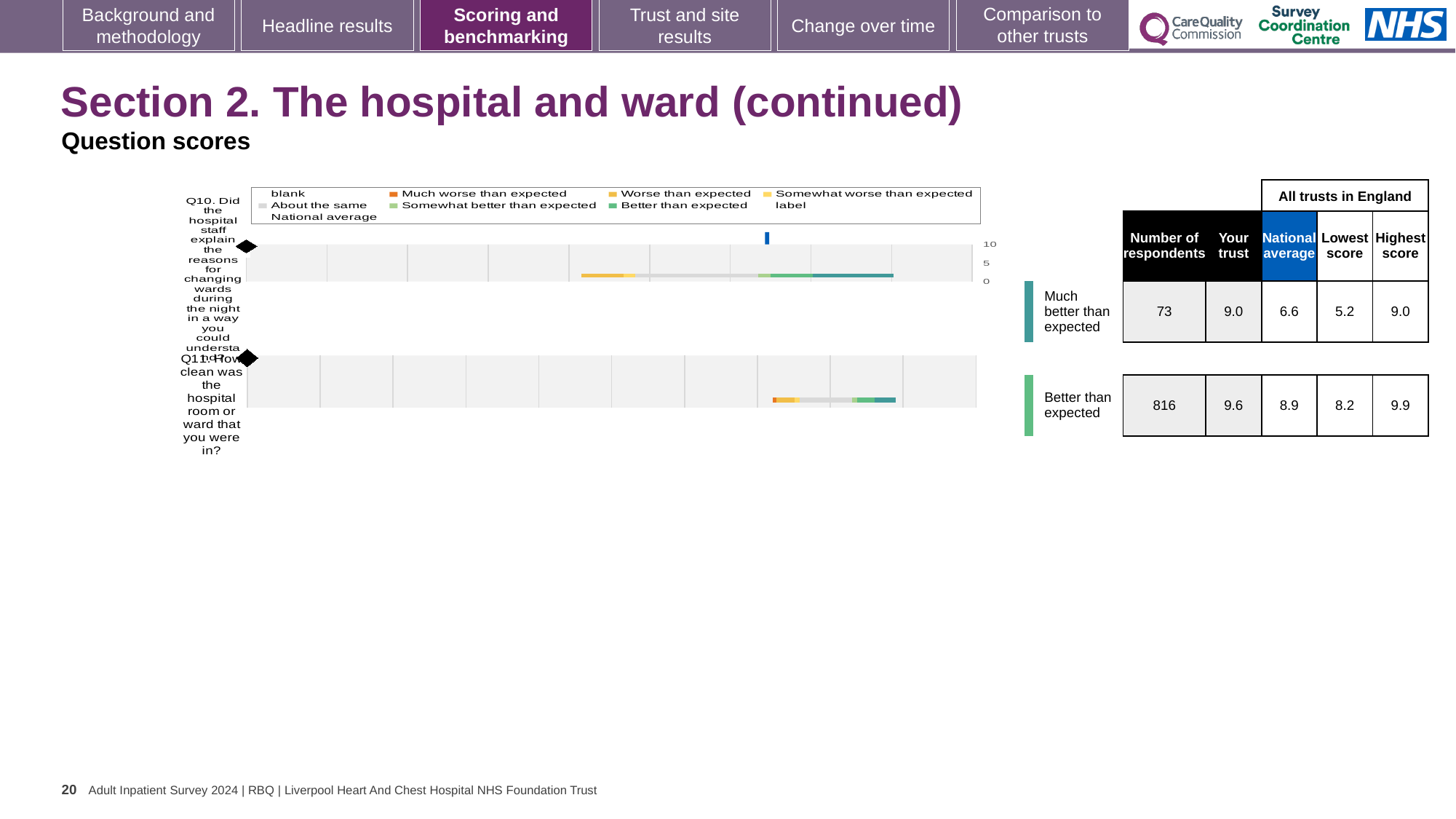
What is the 'Your trust' score for Q11 (how clean was the hospital room or ward)? 9.6 What is the 'Your trust' score for Q10 (explaining reasons for changing wards during the night)? 9.0 For Q11, which is larger: the trust's score or the national average? the trust's score What kind of chart is shown on the slide? bar chart What is the national average score for Q11? 8.9 How many respondents answered Q10? 73 How many respondents answered Q11? 816 What is the difference between the trust's score and the national average for Q10? 2.4 How many survey questions are plotted in the chart? 2 What is the highest score among all trusts in England for Q11? 9.9 What benchmark rating is shown for Q10? Much better than expected Which two questions are plotted in the chart? Q10 and Q11